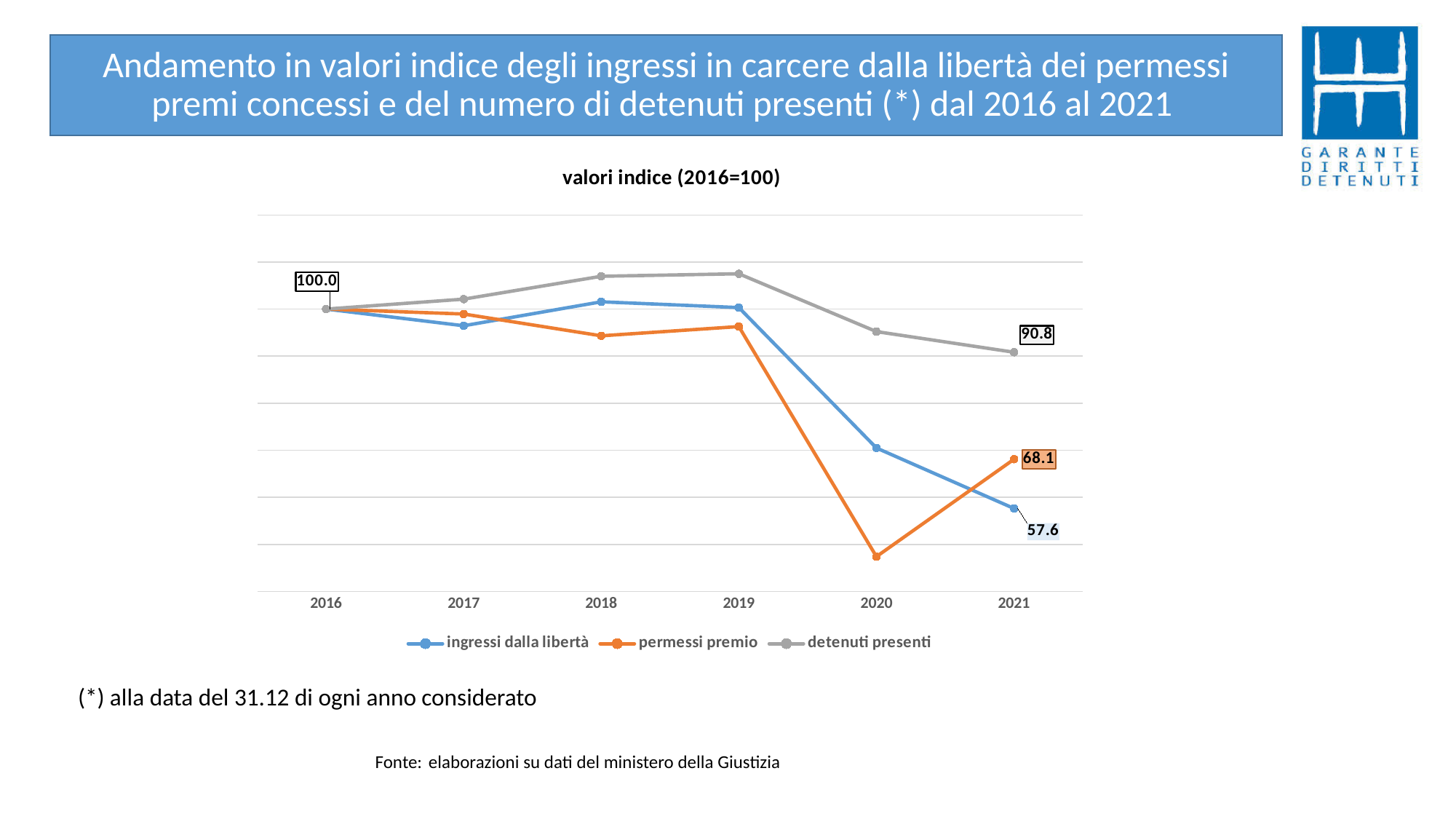
What kind of chart is shown on the slide? line chart Which series has the highest value in 2021? detenuti presenti How many years are plotted along the x axis? 6 Which series has the lowest value in 2021? ingressi dalla libertà What is the index value for ingressi dalla libertà in 2021? 57.6 What is the index value for detenuti presenti in 2021? 90.8 What is the difference between the 2021 values of detenuti presenti and ingressi dalla libertà? 33.2 What is the index value shown for 2016? 100.0 What is the title printed above the chart? valori indice (2016=100) How many series does the legend list? 3 What is the index value for permessi premio in 2021? 68.1 In which year does permessi premio reach its lowest value? 2020